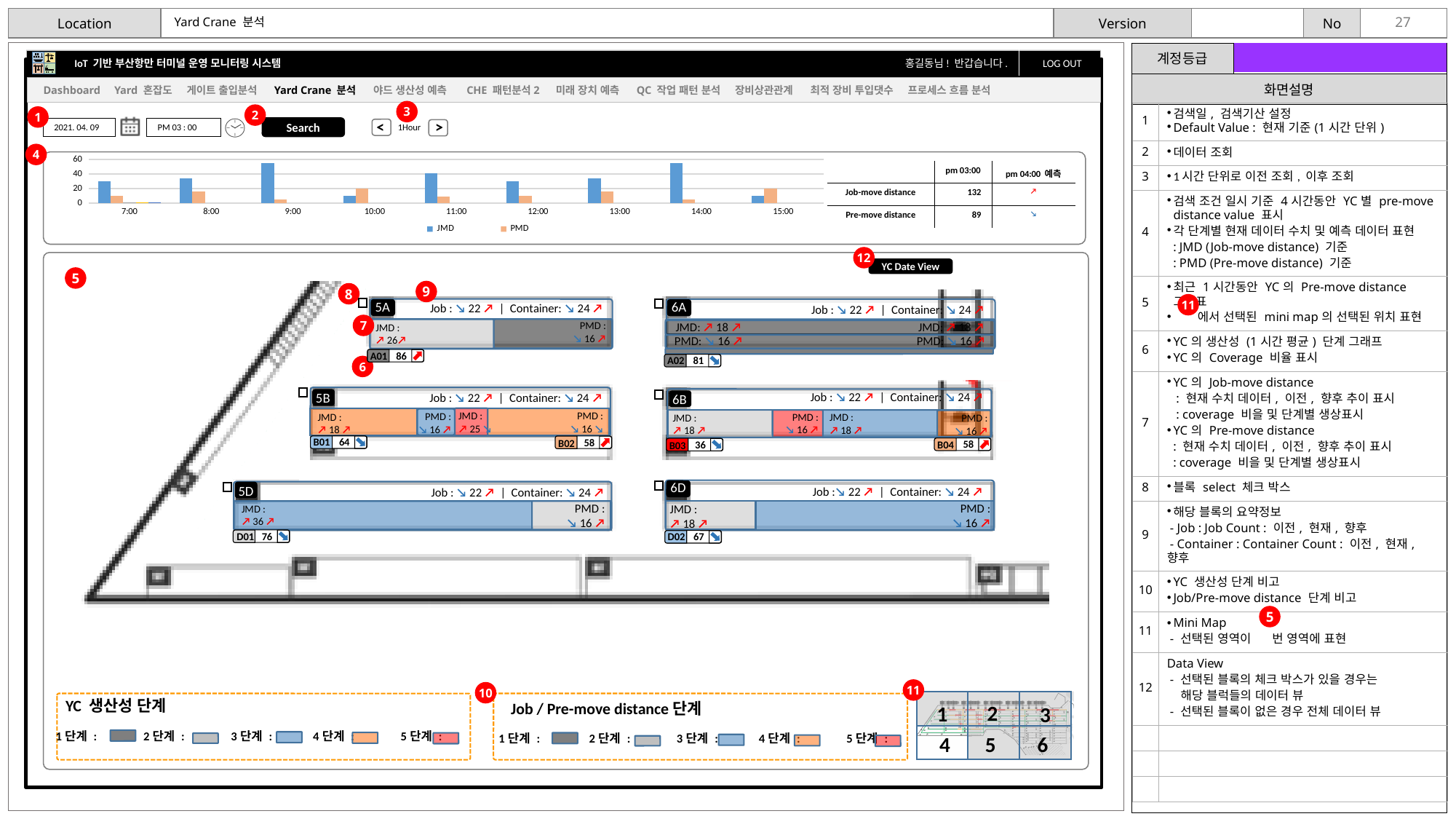
In the top bar chart, is the JMD value at 11:00 greater or less than 20? greater What kind of chart is shown at the top of the slide (area 4)? bar chart In the top bar chart, is the JMD value at 9:00 greater or less than 40? greater In the top bar chart, is the JMD value at 14:00 greater or less than 40? greater How many series does the legend of the top bar chart list? 2 In the top bar chart, which series has the larger value at 9:00, JMD or PMD? JMD How many time categories are shown on the x axis of the top bar chart? 9 What is the highest tick value shown on the y axis of the top bar chart? 60 In the top bar chart, which series has the larger value at 10:00, JMD or PMD? PMD What are the two series named in the legend of the top bar chart? JMD and PMD